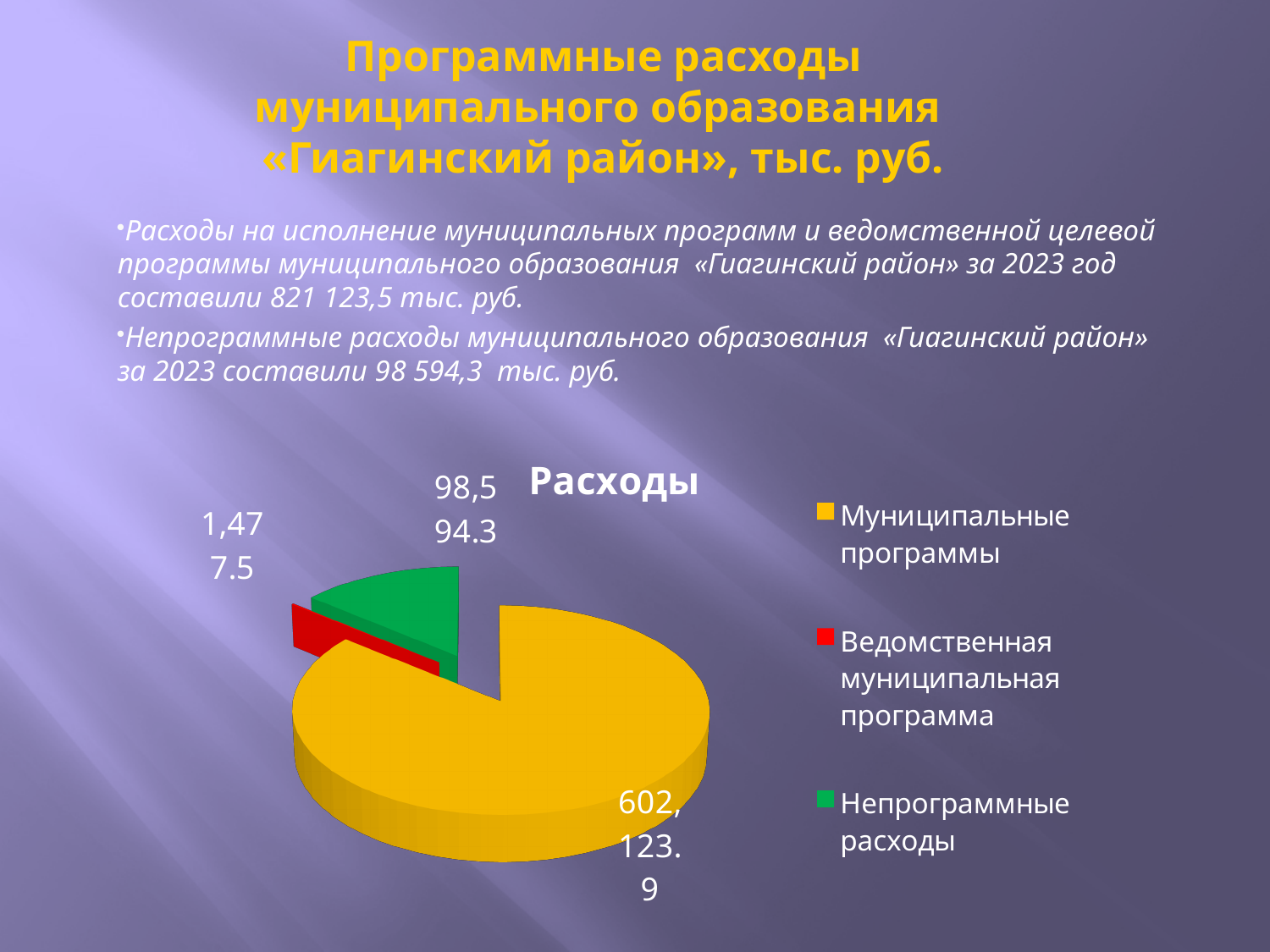
What colour is the slice for Непрограммные расходы? Green What is the value for Ведомственная муниципальная программа? 1,477.5 Which category has the largest slice of the pie? Муниципальные программы How many slices does the pie chart have? 3 What is the title of the chart? Расходы What is the value for Непрограммные расходы? 98,594.3 What kind of chart is shown on the slide? Pie chart How many entries does the chart legend list? 3 What is the value for Муниципальные программы? 602,123.9 Which category has the smallest slice of the pie? Ведомственная муниципальная программа What is the difference between Муниципальные программы and Непрограммные расходы? 503,529.6 Which is larger: Непрограммные расходы or Ведомственная муниципальная программа? Непрограммные расходы